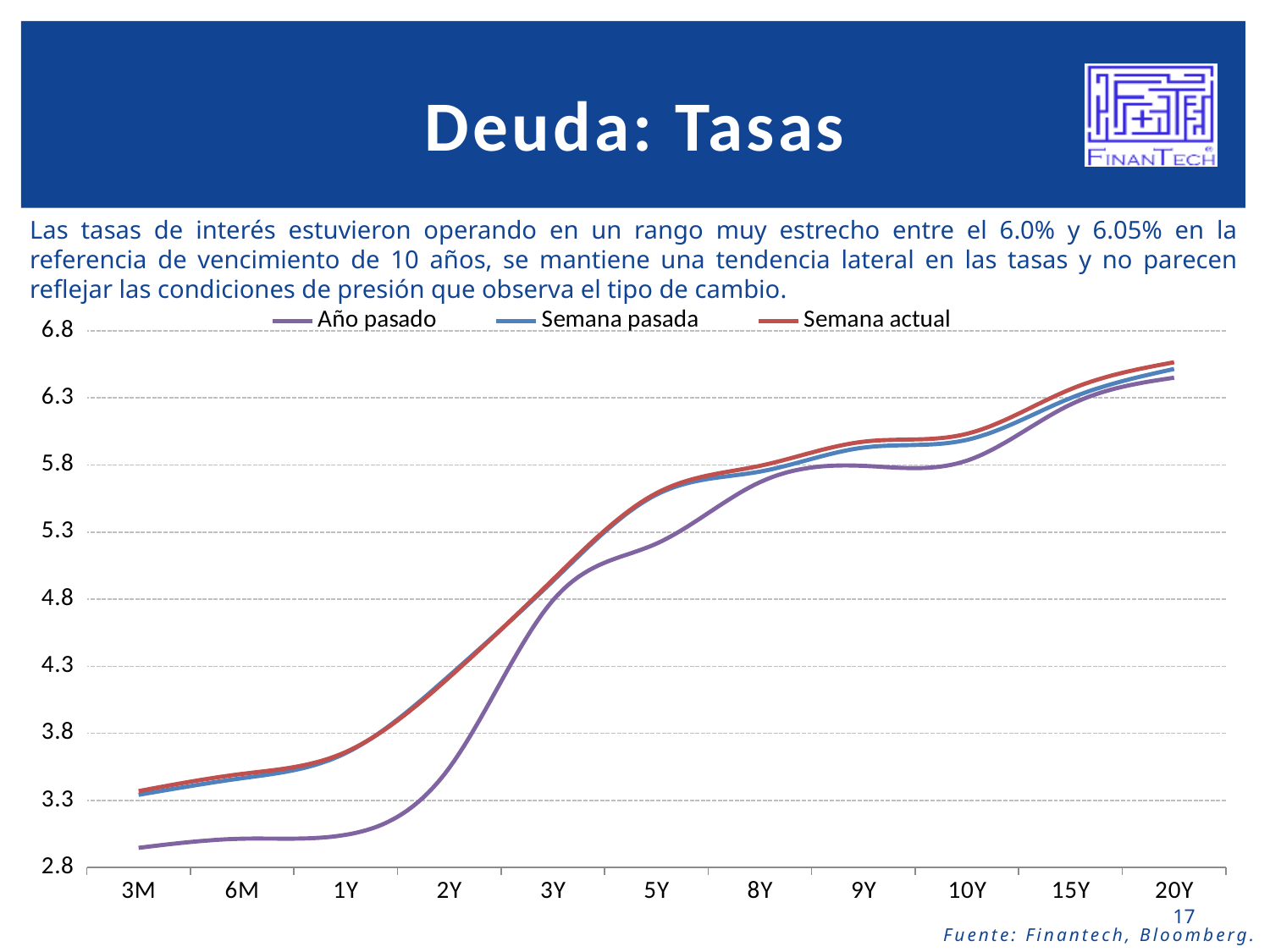
Is the value for Año pasado at 3M greater or less than 3.3? less Do the values of the Semana actual series generally rise or fall from 3M to 20Y? rise At 5Y, which is larger: Año pasado or Semana actual? Semana actual For the Año pasado series, at which maturity is the value highest? 20Y Which colour is used for the Año pasado series? purple Is the value for Semana actual at 20Y greater or less than 6.3? greater At 3M, which is larger: Semana actual or Año pasado? Semana actual Is the value for Semana actual at 10Y greater or less than 5.8? greater How many maturity categories are shown on the x axis? 11 What kind of chart is shown on the slide? line chart How many series does the legend list? 3